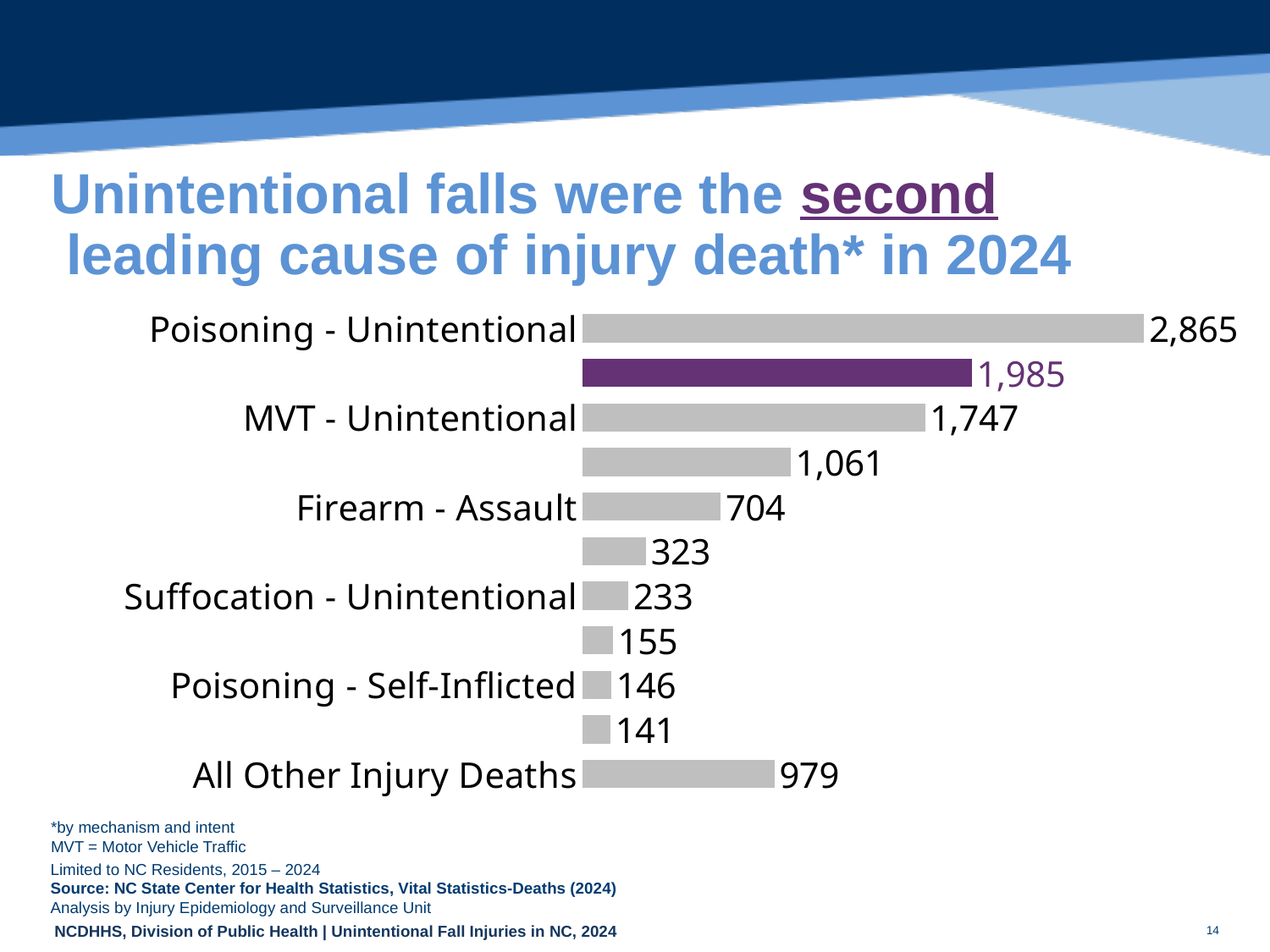
What is the difference between the values for Poisoning - Unintentional and MVT - Unintentional? 1,118 What is the value shown for All Other Injury Deaths? 979 What is the value shown for Firearm - Assault? 704 Which is larger, the value for Firearm - Assault or the value for All Other Injury Deaths? All Other Injury Deaths How many bars are plotted in the chart? 11 What kind of chart is shown on the slide? Bar chart What is the value shown for Poisoning - Unintentional? 2,865 What is the value shown for MVT - Unintentional? 1,747 What is the value shown for Poisoning - Self-Inflicted? 146 What value is labelled on the purple bar in the chart? 1,985 What is the value shown for Suffocation - Unintentional? 233 Which category has the highest value in the chart? Poisoning - Unintentional